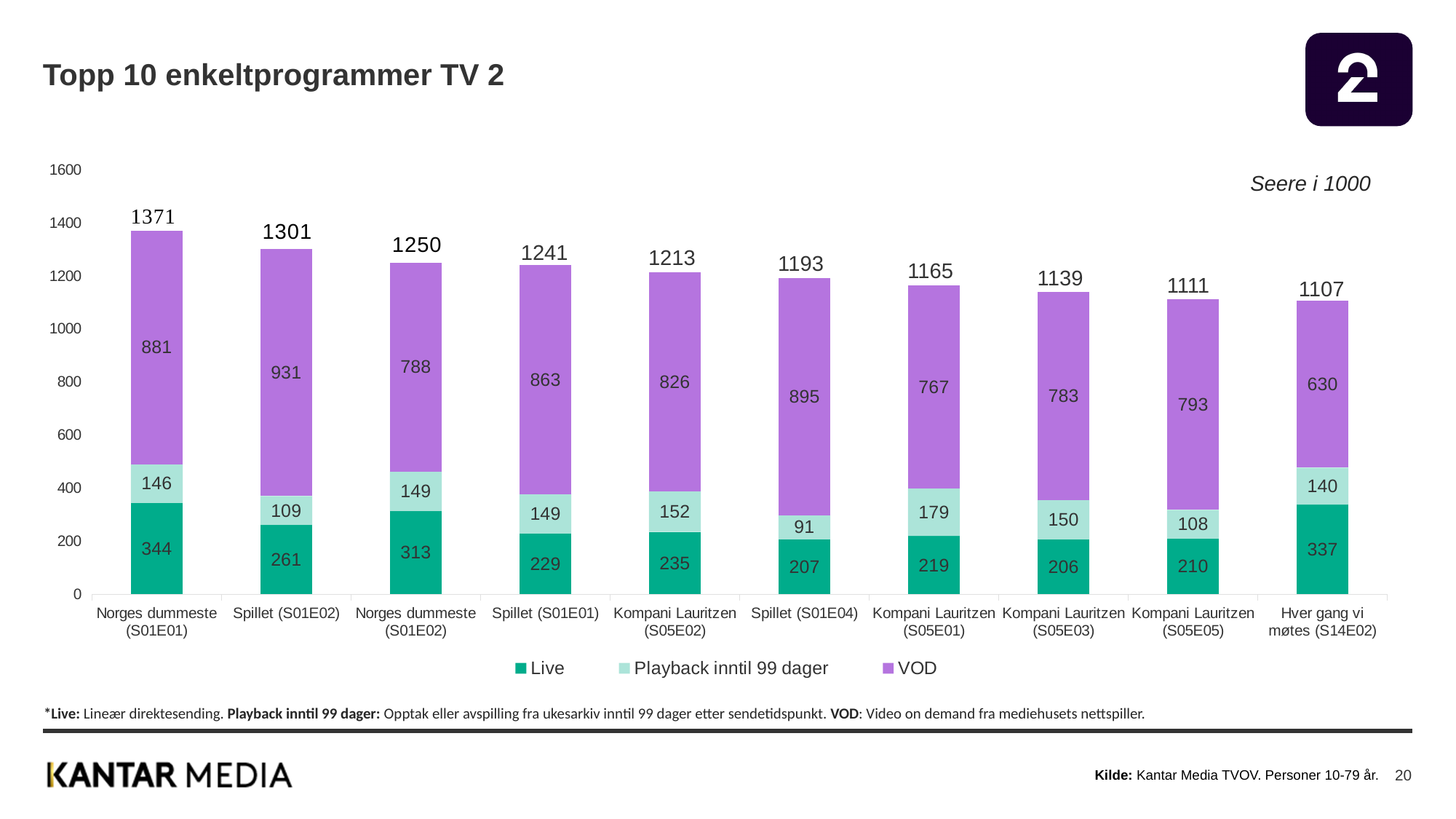
What kind of chart is shown? Stacked bar chart What is the title of the chart? Topp 10 enkeltprogrammer TV 2 What is the Live value for Hver gang vi møtes (S14E02)? 337 What is the total for Kompani Lauritzen (S05E02)? 1213 Which programme has the lowest total? Hver gang vi møtes (S14E02) What is the VOD value for Spillet (S01E02)? 931 Which programme has the highest total? Norges dummeste (S01E01) What is the difference between the totals of Norges dummeste (S01E01) and Spillet (S01E02)? 70 What is the Playback inntil 99 dager value for Spillet (S01E04)? 91 How many programmes are shown on the x axis? 10 How many series does the legend list? 3 Which is larger: the Live value for Norges dummeste (S01E02) or the Live value for Spillet (S01E02)? Norges dummeste (S01E02)